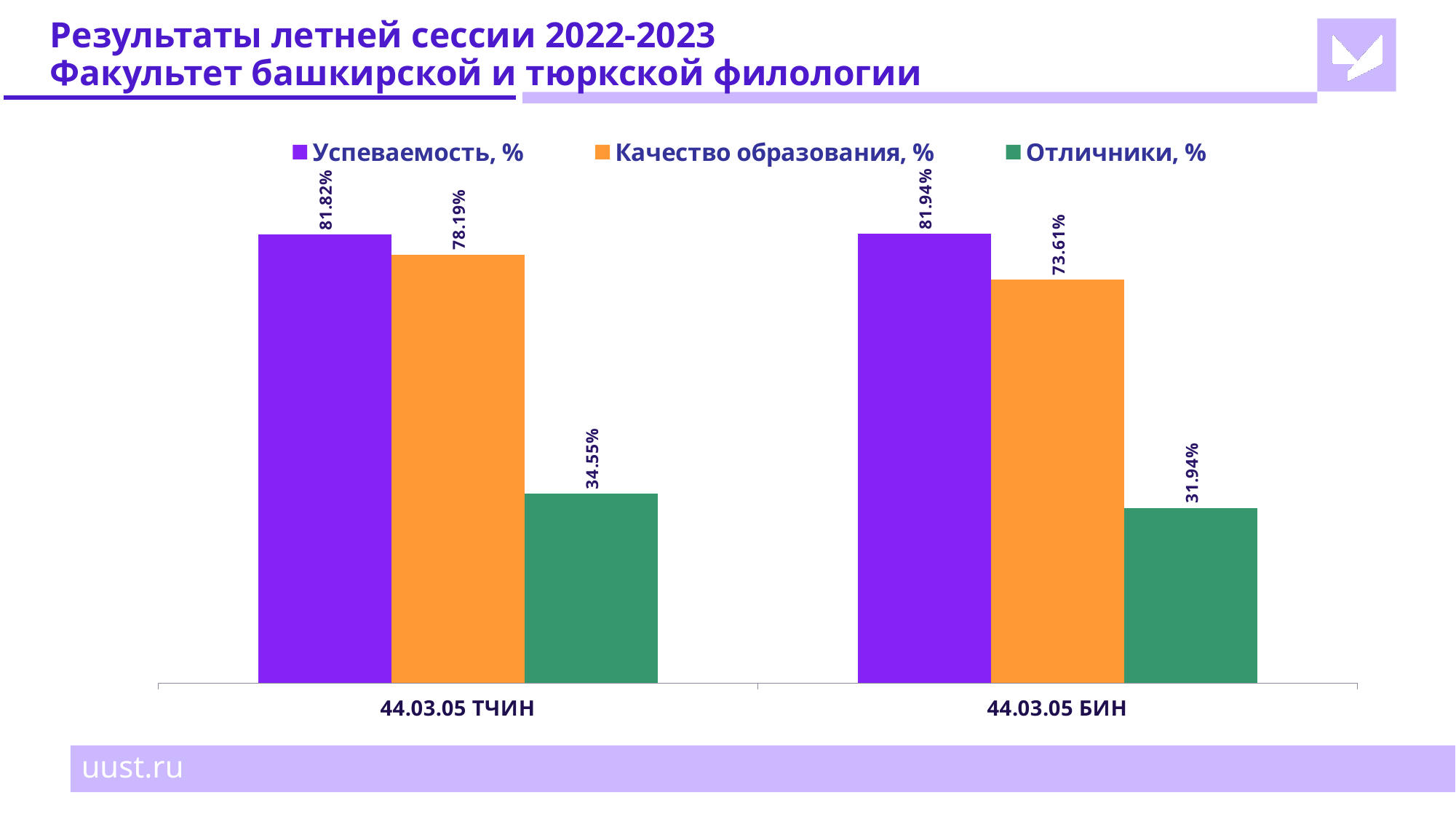
How many categories are shown on the x axis of the chart? 2 What is the value of Отличники, % for 44.03.05 БИН? 31.94% Which category has the larger value for Качество образования, %: 44.03.05 ТЧИН or 44.03.05 БИН? 44.03.05 ТЧИН What is the value of Успеваемость, % for 44.03.05 ТЧИН? 81.82% How many series does the legend list? 3 Which series has the lowest value for 44.03.05 БИН? Отличники, % What is the value of Отличники, % for 44.03.05 ТЧИН? 34.55% What is the difference between Отличники, % for 44.03.05 ТЧИН and for 44.03.05 БИН? 2.61% What is the difference between Качество образования, % for 44.03.05 ТЧИН and for 44.03.05 БИН? 4.58% What is the value of Качество образования, % for 44.03.05 БИН? 73.61% Which series has the highest value for 44.03.05 ТЧИН? Успеваемость, % What kind of chart is shown on the slide? Bar chart